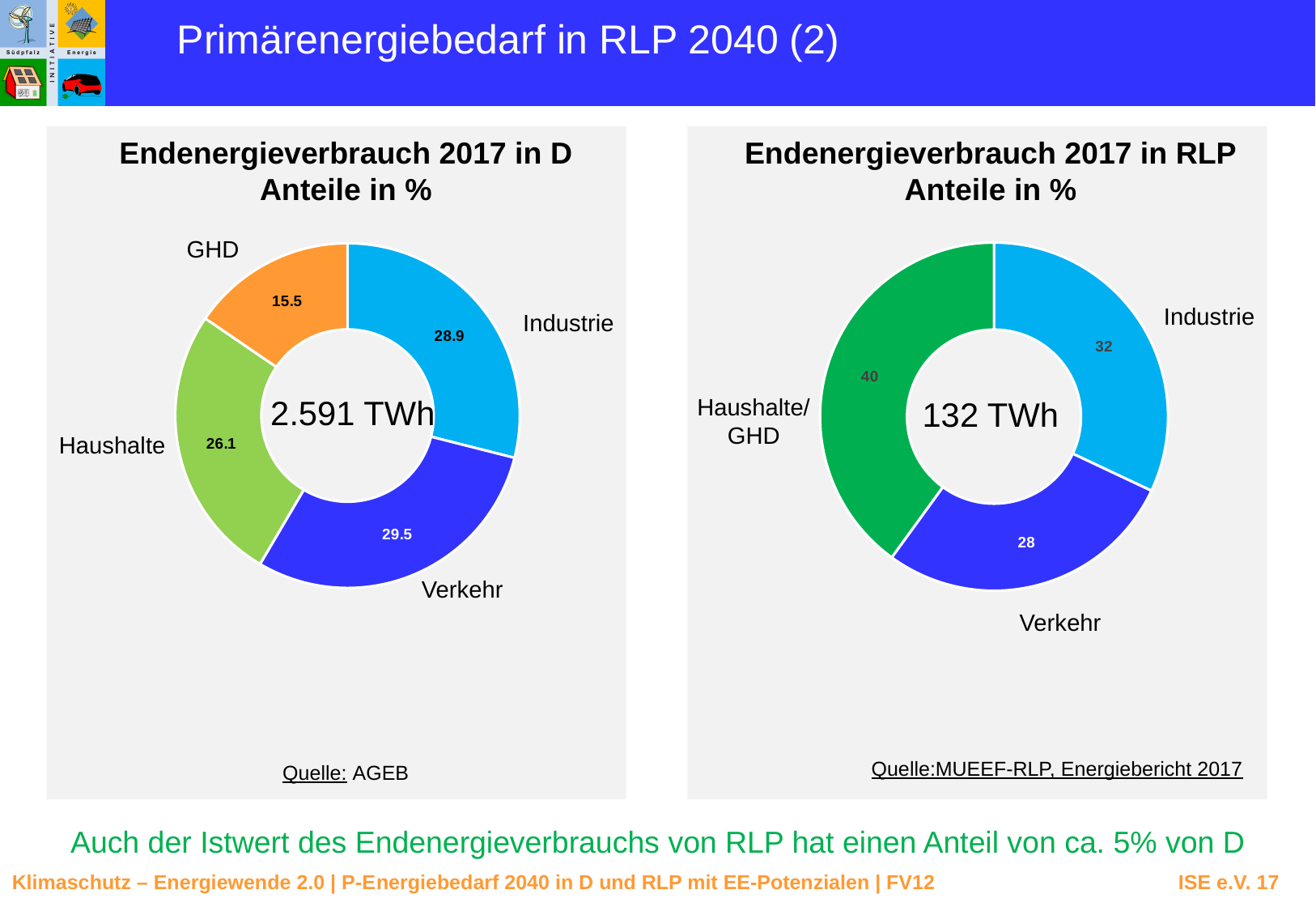
In the chart 'Endenergieverbrauch 2017 in D', which category has the smallest share? GHD In the chart 'Endenergieverbrauch 2017 in RLP', what is the share for Haushalte/GHD? 40 In the chart 'Endenergieverbrauch 2017 in RLP', is the share for Industrie larger or smaller than the share for Verkehr? larger In the chart 'Endenergieverbrauch 2017 in D', what is the share for Industrie? 28.9 In the chart 'Endenergieverbrauch 2017 in D', how many categories are shown? 4 In the chart 'Endenergieverbrauch 2017 in RLP', which category has the largest share? Haushalte/GHD What kind of chart is 'Endenergieverbrauch 2017 in RLP'? Doughnut chart In the chart 'Endenergieverbrauch 2017 in RLP', what is the share for Verkehr? 28 What total value is shown in the centre of the chart 'Endenergieverbrauch 2017 in D'? 2.591 TWh In the chart 'Endenergieverbrauch 2017 in D', what is the difference between the shares of Verkehr and Haushalte? 3.4 In the chart 'Endenergieverbrauch 2017 in D', what is the share for GHD? 15.5 In the chart 'Endenergieverbrauch 2017 in D', which category has the largest share? Verkehr